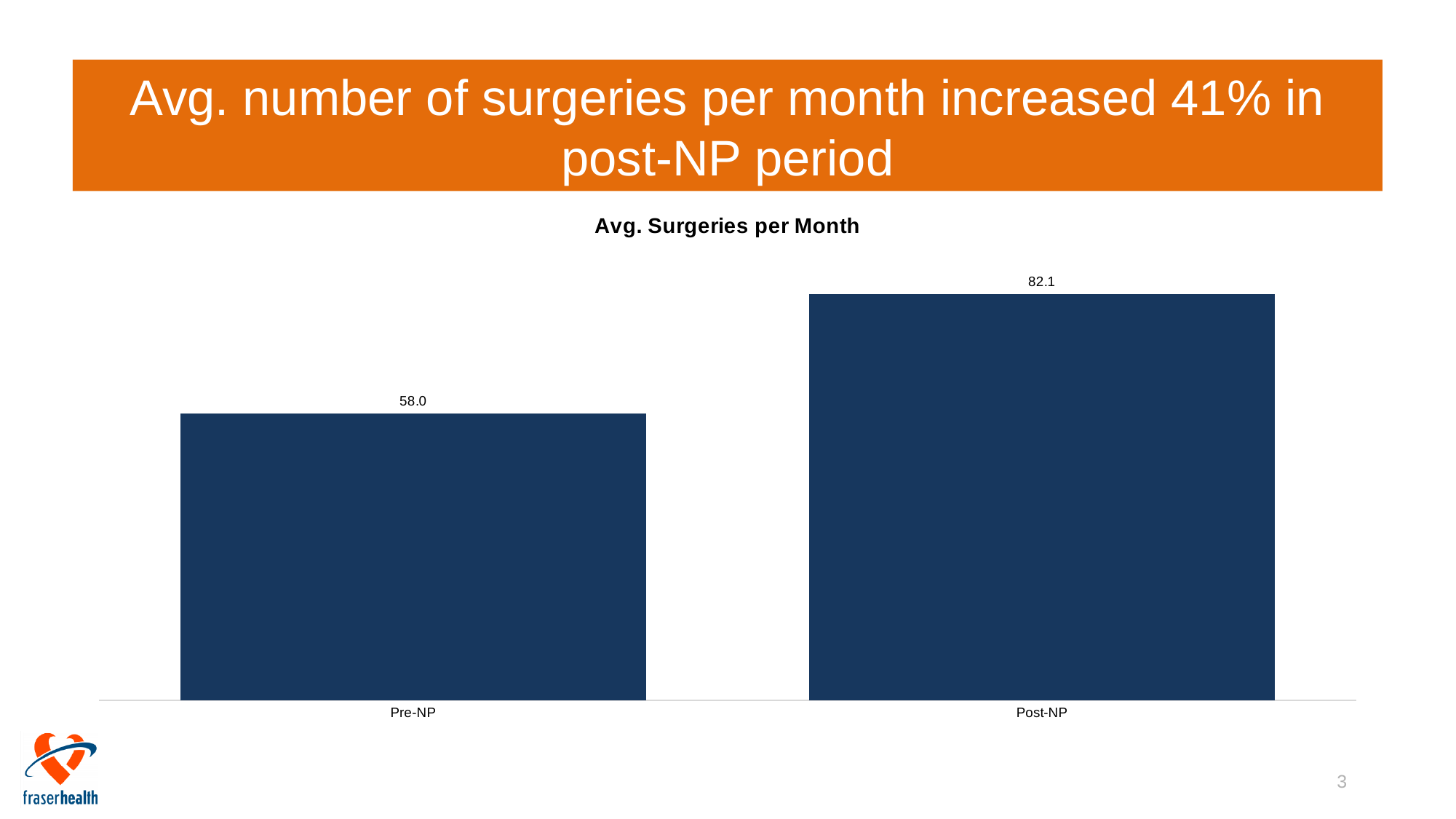
What is the average number of surgeries per month in the Post-NP period? 82.1 Which period has the lower average number of surgeries per month? Pre-NP What colour are the bars in the chart? dark blue What kind of chart is shown on the slide? bar chart What is the title of the chart? Avg. Surgeries per Month What is the difference between the Post-NP and Pre-NP average surgeries per month? 24.1 Is the value for Post-NP larger or smaller than the value for Pre-NP? larger How many categories are shown on the chart? 2 Which period has the higher average number of surgeries per month? Post-NP What is the average number of surgeries per month in the Pre-NP period? 58.0 Do the values rise or fall from Pre-NP to Post-NP? rise